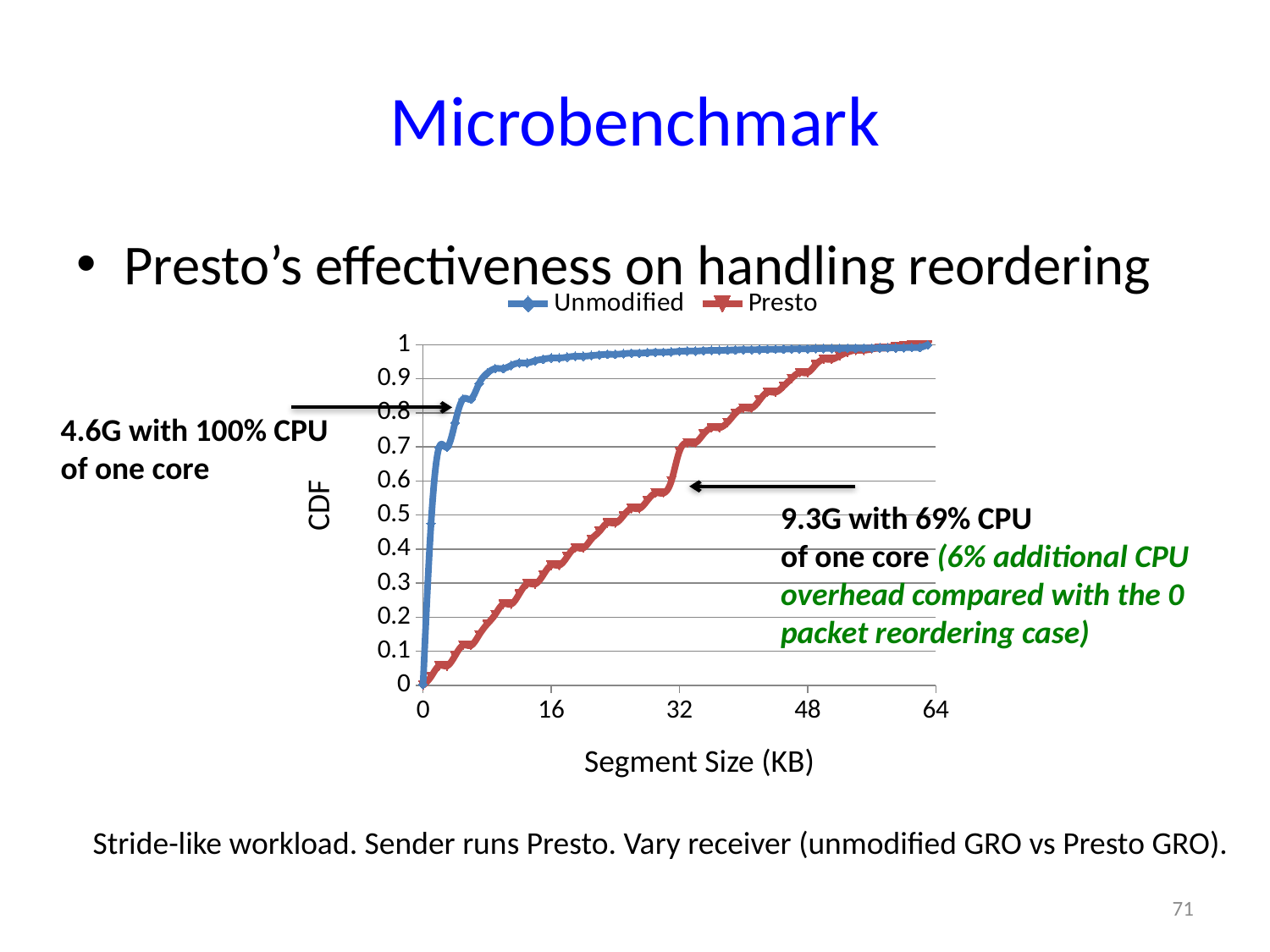
How many series does the chart's legend list? 2 At a segment size of 32 KB, which series has the lower CDF value, Unmodified or Presto? Presto Is the CDF value for the Presto series at a segment size of 16 KB greater or less than 0.5? less Is the CDF value for the Presto series at a segment size of 48 KB greater or less than 0.8? greater Do the CDF values for the Presto series rise or fall as segment size increases along the x axis? rise At a segment size of 16 KB, which series has the higher CDF value, Unmodified or Presto? Unmodified What are the two series named in the chart's legend? Unmodified and Presto According to the annotation on the chart, what throughput and CPU usage does Presto achieve? 9.3G with 69% CPU of one core Which series reaches a CDF of 0.9 at a smaller segment size, Unmodified or Presto? Unmodified What kind of chart is shown on the slide? line chart Is the CDF value for the Unmodified series at a segment size of 8 KB greater or less than 0.8? greater